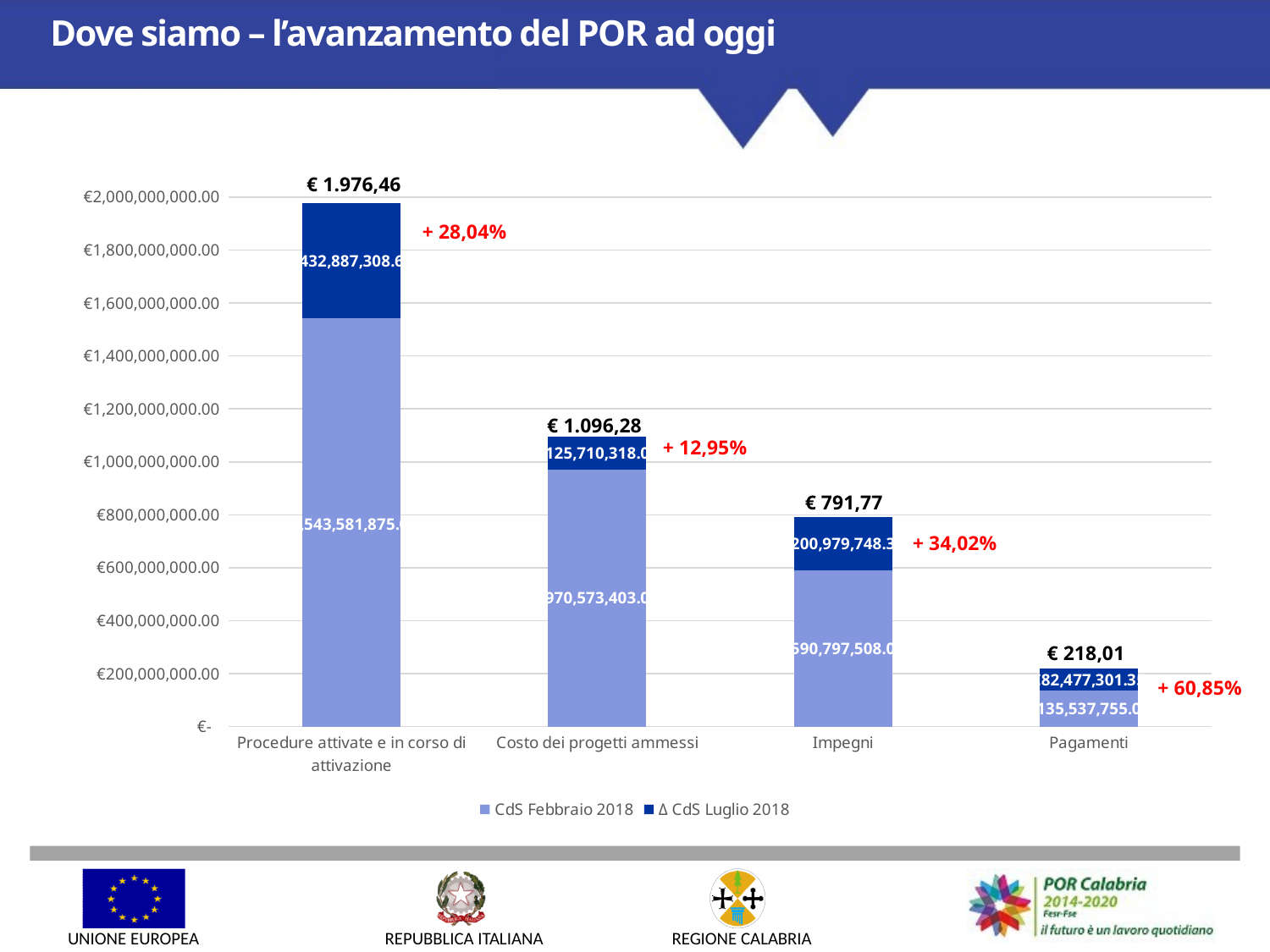
What total value is printed above the Impegni bar? € 791,77 How many categories are shown on the x axis of the chart? 4 What are the two series names listed in the chart legend? CdS Febbraio 2018 and Δ CdS Luglio 2018 Which category has the shortest stacked bar? Pagamenti What percentage increase is printed in red next to the Procedure attivate e in corso di attivazione bar? + 28,04% Which category has the tallest stacked bar? Procedure attivate e in corso di attivazione What kind of chart is shown on the slide? bar chart How many series does the chart legend list? 2 Is the total height of the Impegni bar greater or less than €1,000,000,000.00? less Which stacked bar is taller: Costo dei progetti ammessi or Impegni? Costo dei progetti ammessi What percentage increase is printed in red next to the Pagamenti bar? + 60,85% Do the stacked bar totals rise or fall from left to right across the x axis? fall